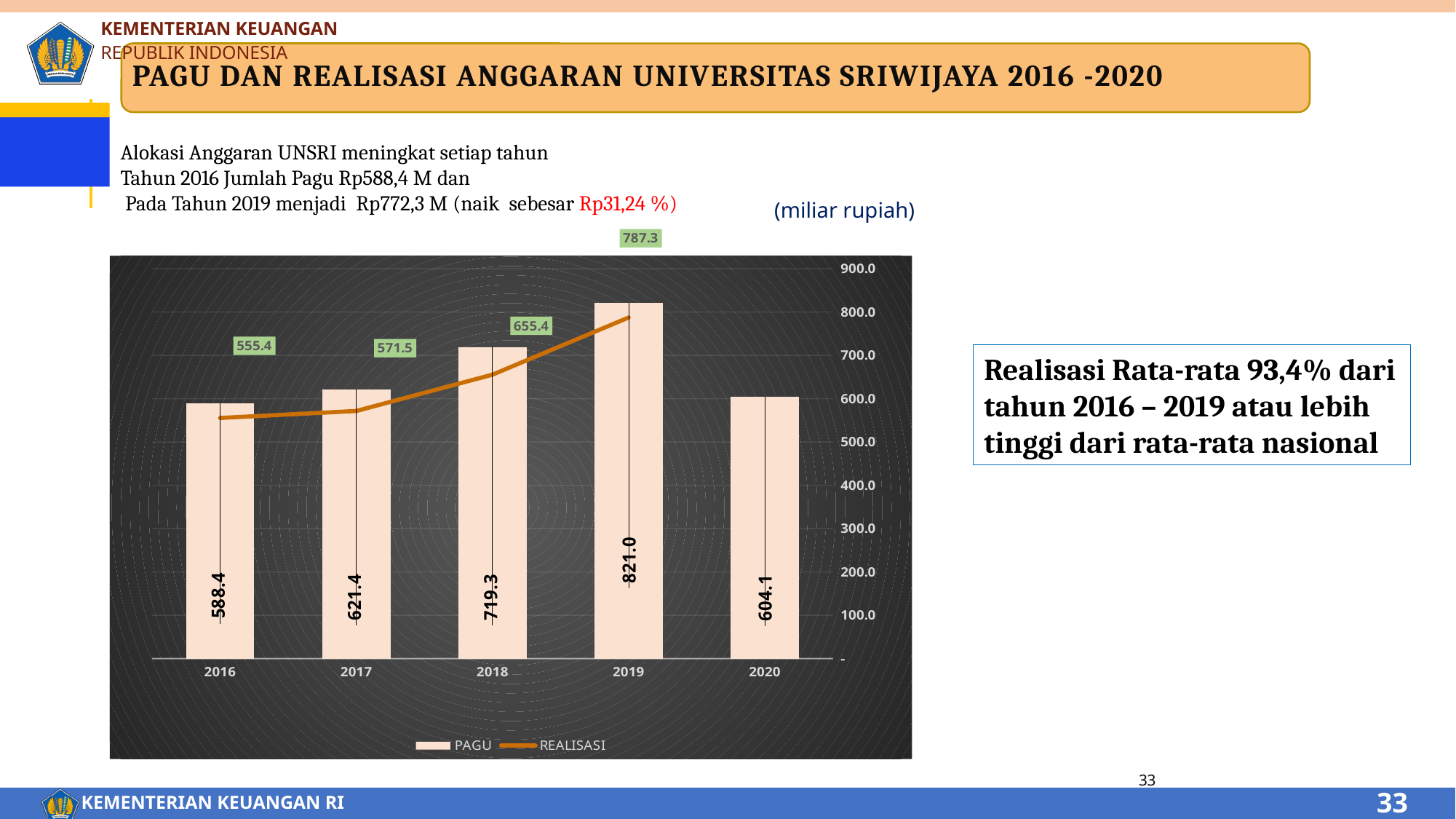
Which year has the highest PAGU value? 2019 How many years are shown on the x axis of the chart? 5 What is the PAGU value for 2018? 719.3 Which is larger, the PAGU value for 2017 or the PAGU value for 2020? 2017 Which year has the lowest PAGU value? 2016 What kind of chart is used to show the PAGU series? bar chart What is the REALISASI value for 2017? 571.5 How many series does the chart legend list? 2 What is the difference between the PAGU and REALISASI values in 2019? 33.7 What is the PAGU value for 2020? 604.1 Is the REALISASI value for 2018 greater or less than 600.0? greater Does the REALISASI line rise or fall from 2016 to 2019? rise